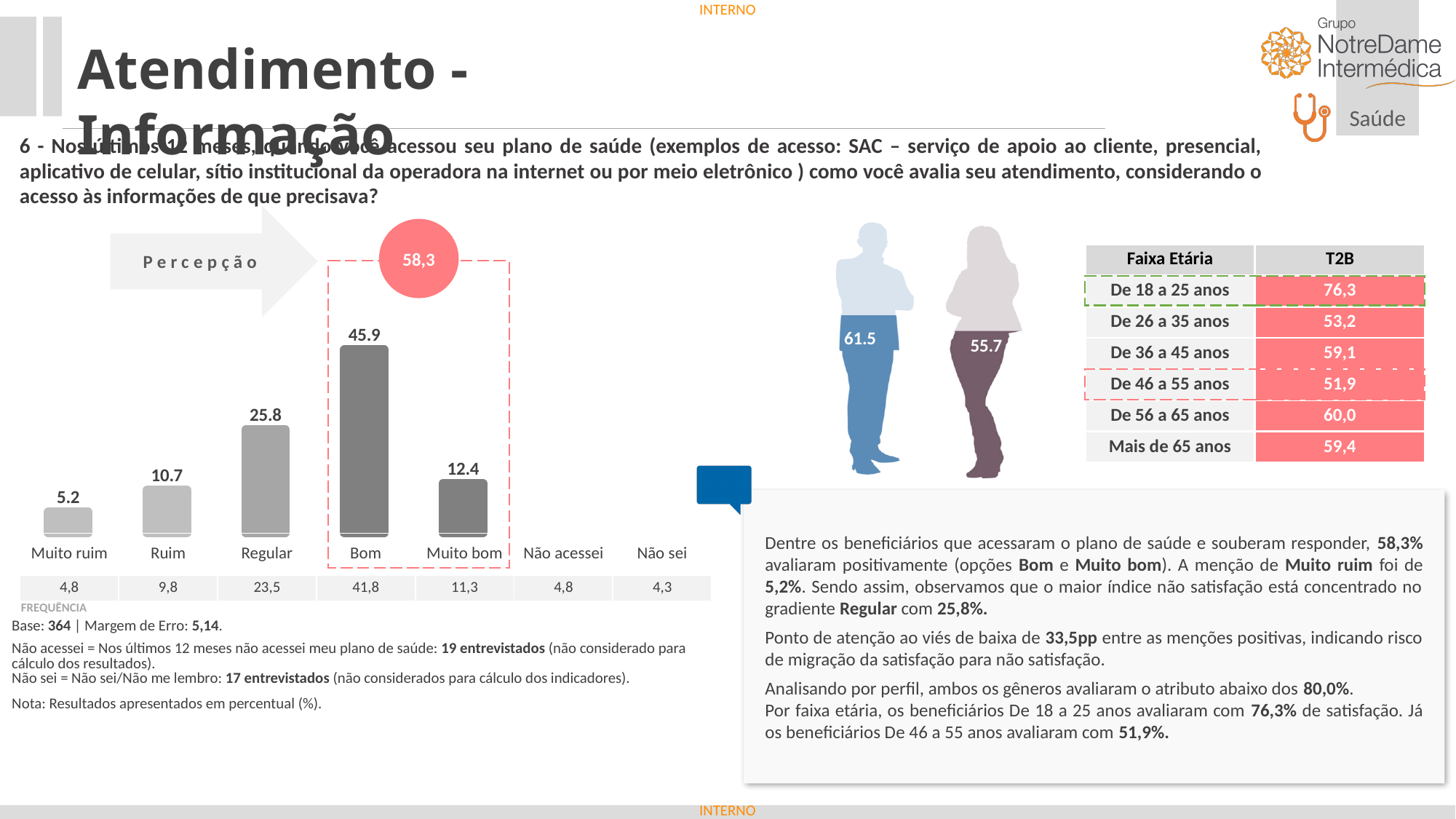
In the bar chart, what is the difference between the values for 'Bom' and 'Muito bom'? 33.5 In the bar chart, what is the value for 'Bom'? 45.9 In the bar chart, what is the value for 'Muito ruim'? 5.2 How many bars are plotted in the bar chart? 5 In the bar chart, which category has the lowest plotted value? Muito ruim What kind of chart is shown on the left of the slide under the 'Percepção' arrow? bar chart In the bar chart, what is the difference between the values for 'Ruim' and 'Muito ruim'? 5.5 In the bar chart, what is the value for 'Regular'? 25.8 In the bar chart, which is larger: the value for 'Regular' or the value for 'Muito bom'? Regular In the bar chart, what is the value for 'Muito bom'? 12.4 What value is shown in the red circle above the dashed box around 'Bom' and 'Muito bom' in the bar chart? 58,3 In the bar chart, which category has the highest value? Bom